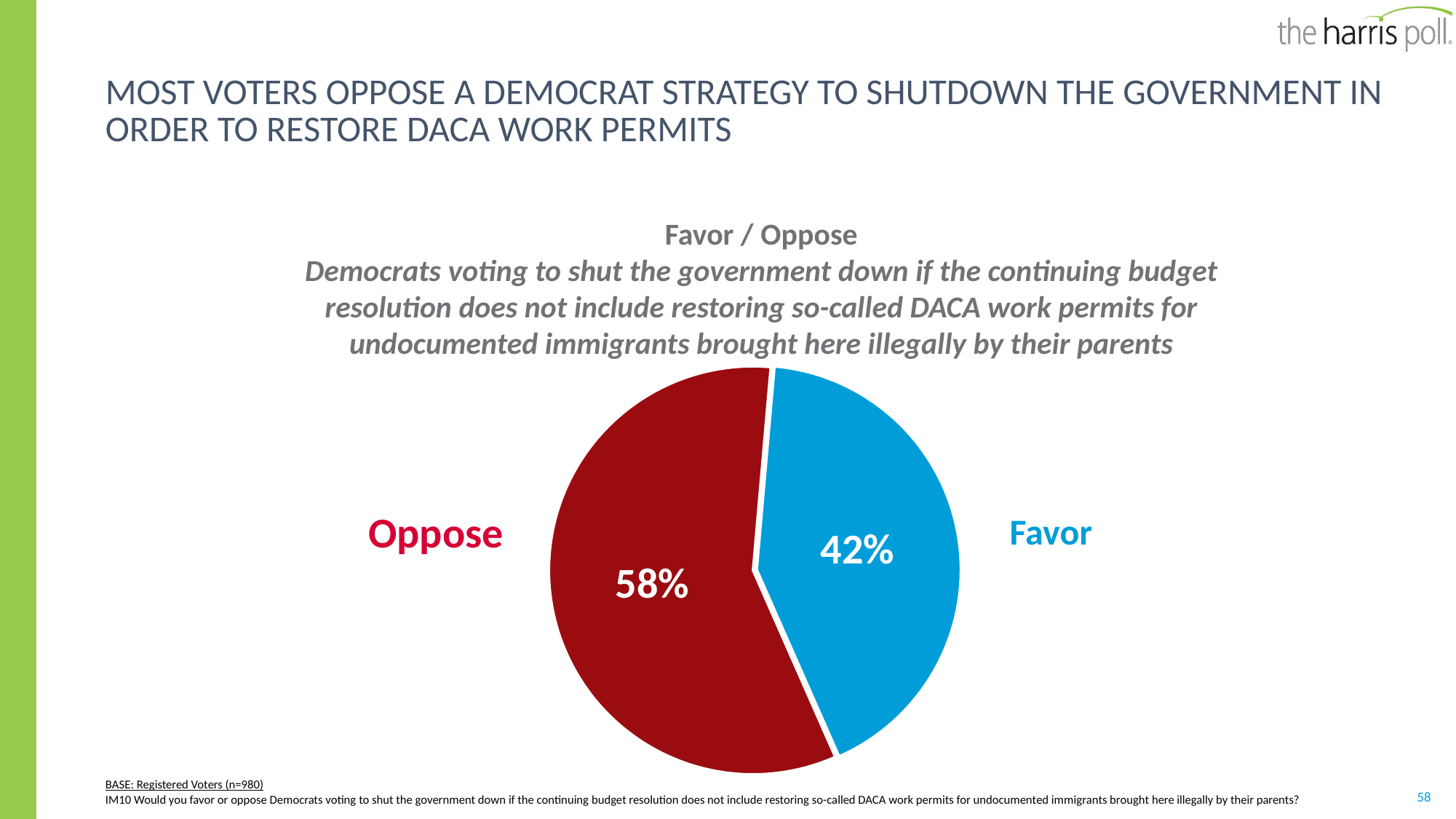
How many slices does the pie chart have? 2 Which slice of the pie is the largest? Oppose Which is larger, the Oppose share or the Favor share? Oppose What colour is the Favor slice of the pie? blue What is the difference in percentage points between Oppose and Favor? 16 What colour is the Oppose slice of the pie? red What kind of chart is shown on the slide? pie chart Which slice of the pie is the smallest? Favor What share of voters favor Democrats voting to shut the government down over DACA work permits? 42% What share of voters oppose Democrats voting to shut the government down over DACA work permits? 58% What is the total of the two slices shown in the pie chart? 100%